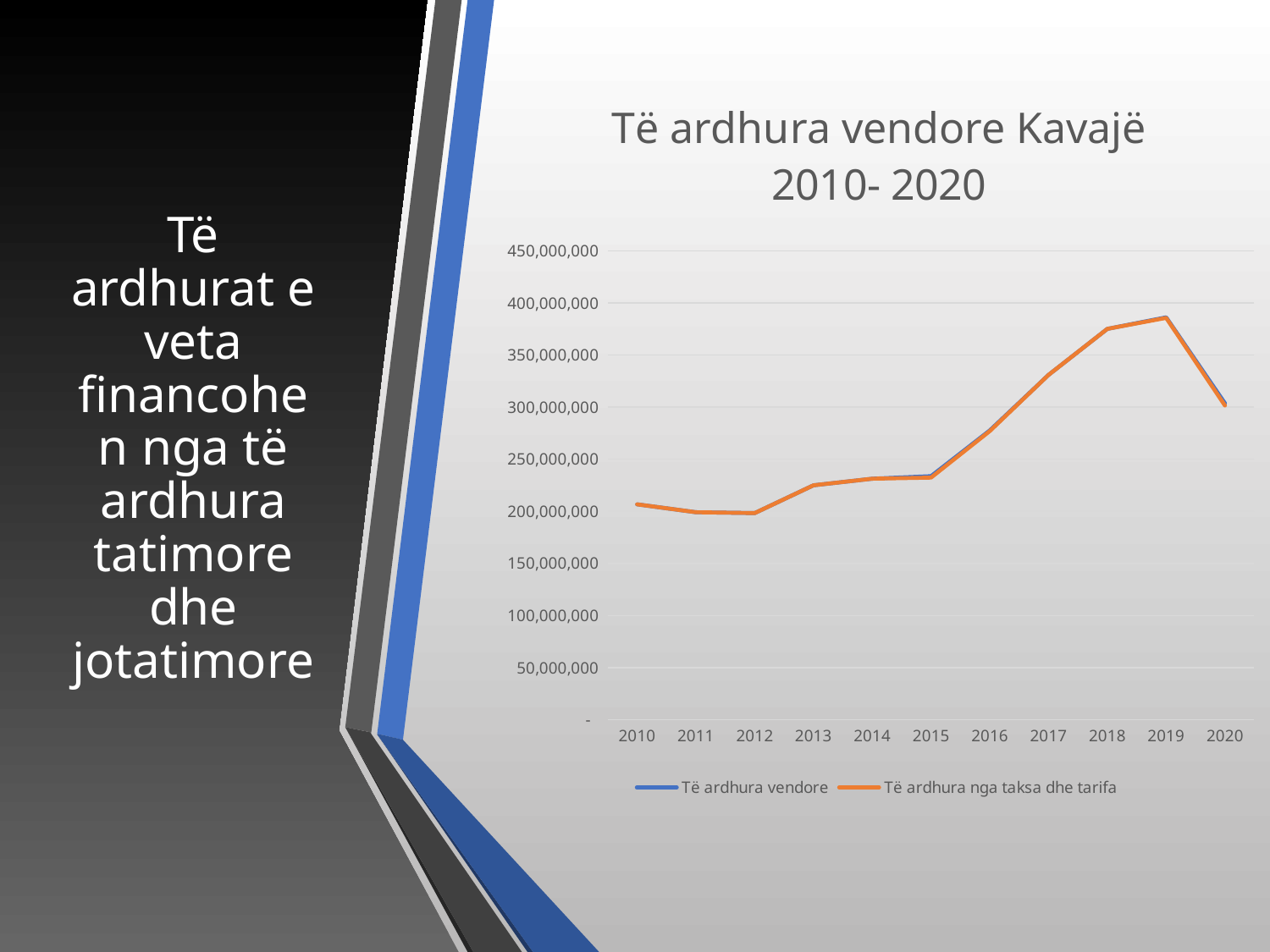
Is the value for 2017 greater or less than 300,000,000? greater What is the title of the chart? Të ardhura vendore Kavajë 2010- 2020 Do the values rise or fall from 2015 to 2019? rise How many series does the legend list? 2 Which series is drawn in orange according to the legend? Të ardhura nga taksa dhe tarifa In which year do the plotted values reach their highest point? 2019 Is the value for 2016 greater or less than 250,000,000? greater What kind of chart is shown on the slide? line chart Is the value for 2019 greater or less than 350,000,000? greater How many years are plotted along the x axis? 11 Which year has the larger value, 2019 or 2020? 2019